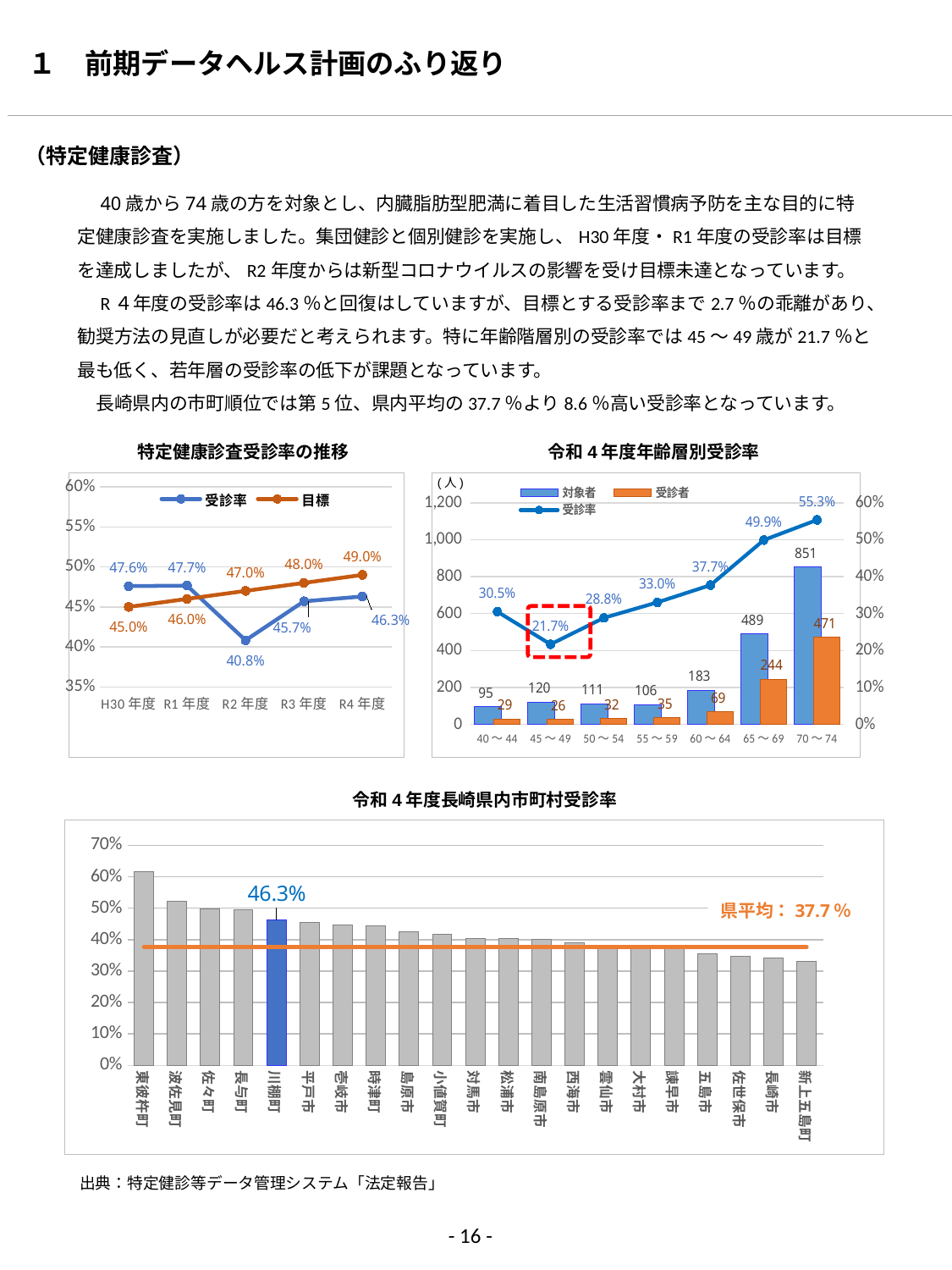
In the chart titled 特定健康診査受診率の推移, what is the difference between the 目標 and the 受診率 for R4 年度? 2.7% In the chart titled 令和4年度年齢層別受診率, what is the 対象者 value for the 70～74 age group? 851 In the chart titled 特定健康診査受診率の推移, what is the 目標 value for R4 年度? 49.0% In the chart titled 令和4年度年齢層別受診率, which age group has the lowest 受診率? 45～49 In the chart titled 特定健康診査受診率の推移, which year has the lowest 受診率? R2 年度 In the chart titled 令和4年度年齢層別受診率, how many age groups are shown on the x axis? 7 In the chart titled 令和4年度長崎県内市町村受診率, is the value for 新上五島町 greater or less than 40%? less In the chart titled 特定健康診査受診率の推移, how many series does the legend list? 2 In the chart titled 令和4年度年齢層別受診率, does the 受診率 rise or fall from 50～54 to 70～74? rise In the chart titled 特定健康診査受診率の推移, what is the 受診率 value for R2 年度? 40.8% In the chart titled 令和4年度年齢層別受診率, what is the 受診者 value for the 65～69 age group? 244 In the chart titled 令和4年度長崎県内市町村受診率, which municipality has the highest value? 東彼杵町